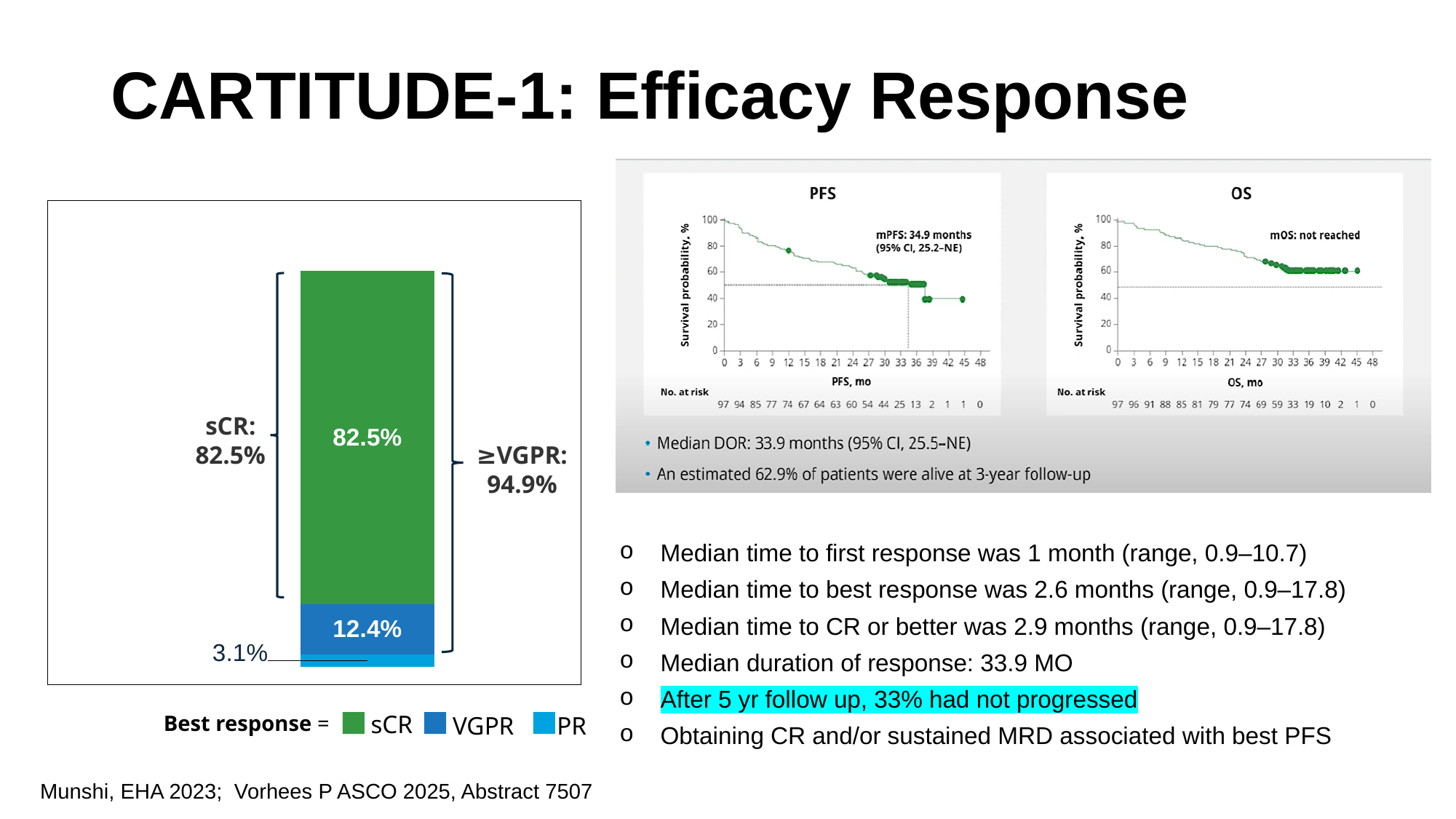
In the best response bar chart, which response category has the smallest segment? PR How many response categories does the legend of the best response bar chart list? 3 In the best response bar chart, which response category has the largest segment? sCR In the best response bar chart, what is the ≥VGPR rate shown next to the bar? 94.9% In the best response bar chart, what is the difference between the sCR and VGPR percentages? 70.1% In the best response bar chart, what percentage of patients achieved PR? 3.1% In the best response bar chart, what percentage of patients achieved VGPR? 12.4% In the best response bar chart, what percentage of patients achieved sCR? 82.5% In the best response bar chart, which is larger, the VGPR segment or the PR segment? VGPR In the PFS chart, what median PFS is annotated on the plot? 34.9 months What type of chart is the best response chart on the left of the slide? Bar chart In the best response bar chart, what is the total of the sCR, VGPR and PR segments? 98.0%